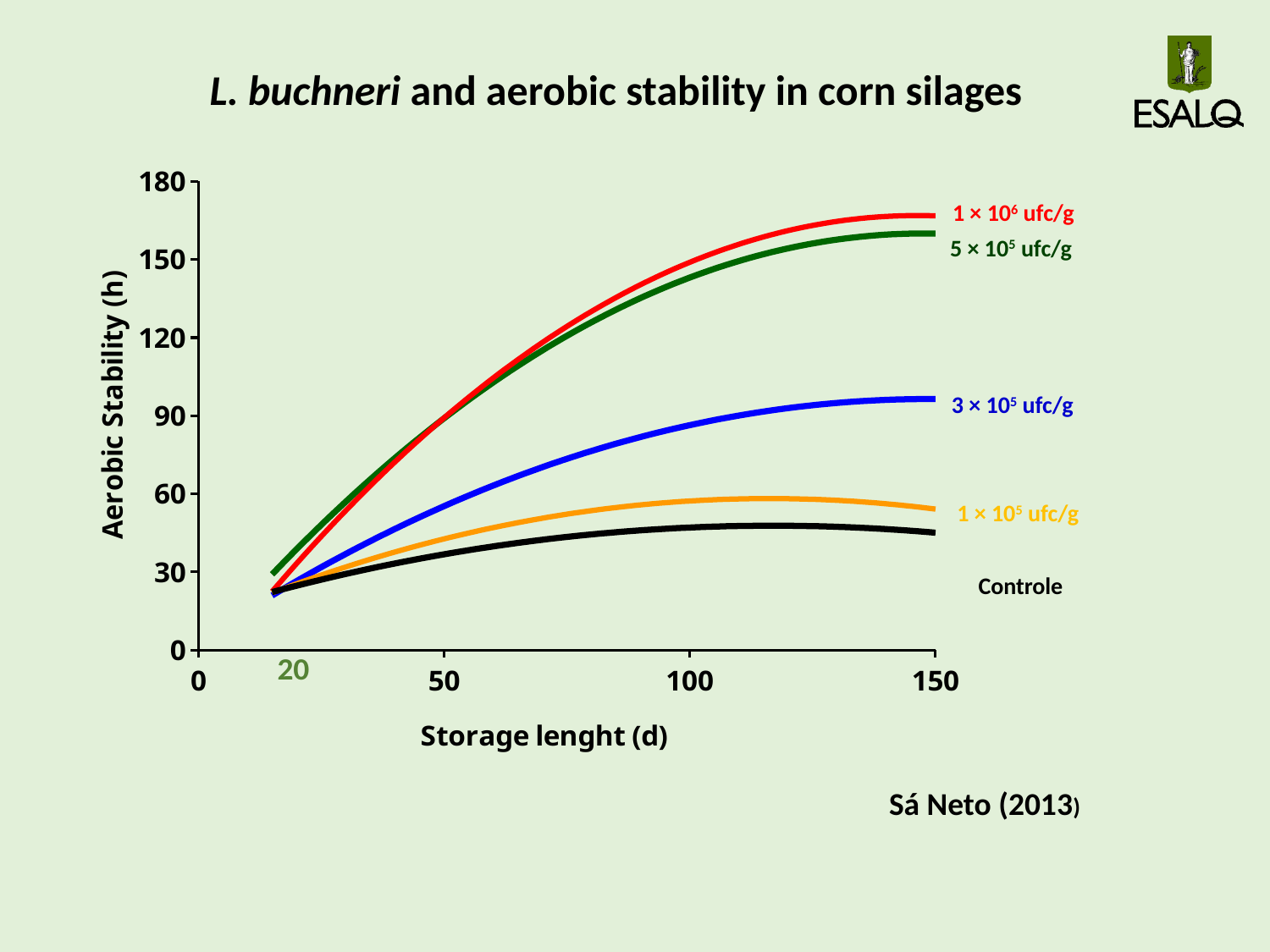
Which series has the lowest aerobic stability at 150 days of storage? Controle Is the aerobic stability of the 1 × 10⁶ ufc/g series at 150 days greater or less than 150 h? greater At 150 days of storage, which has higher aerobic stability: the 1 × 10⁶ ufc/g series or the 3 × 10⁵ ufc/g series? 1 × 10⁶ ufc/g Is the aerobic stability of the 3 × 10⁵ ufc/g series at 150 days greater or less than 120 h? less How many series (lines) are plotted on the chart? 5 Does the aerobic stability of the 1 × 10⁶ ufc/g series rise or fall as storage length increases from 20 to 150 days? rise What kind of chart is shown on the slide? line chart Is the aerobic stability of the Controle series at 150 days greater or less than 60 h? less What is the label of the y axis of the chart? Aerobic Stability (h) Which series has the highest aerobic stability at 150 days of storage? 1 × 10⁶ ufc/g At 150 days of storage, which has higher aerobic stability: the 1 × 10⁵ ufc/g series or the Controle series? 1 × 10⁵ ufc/g